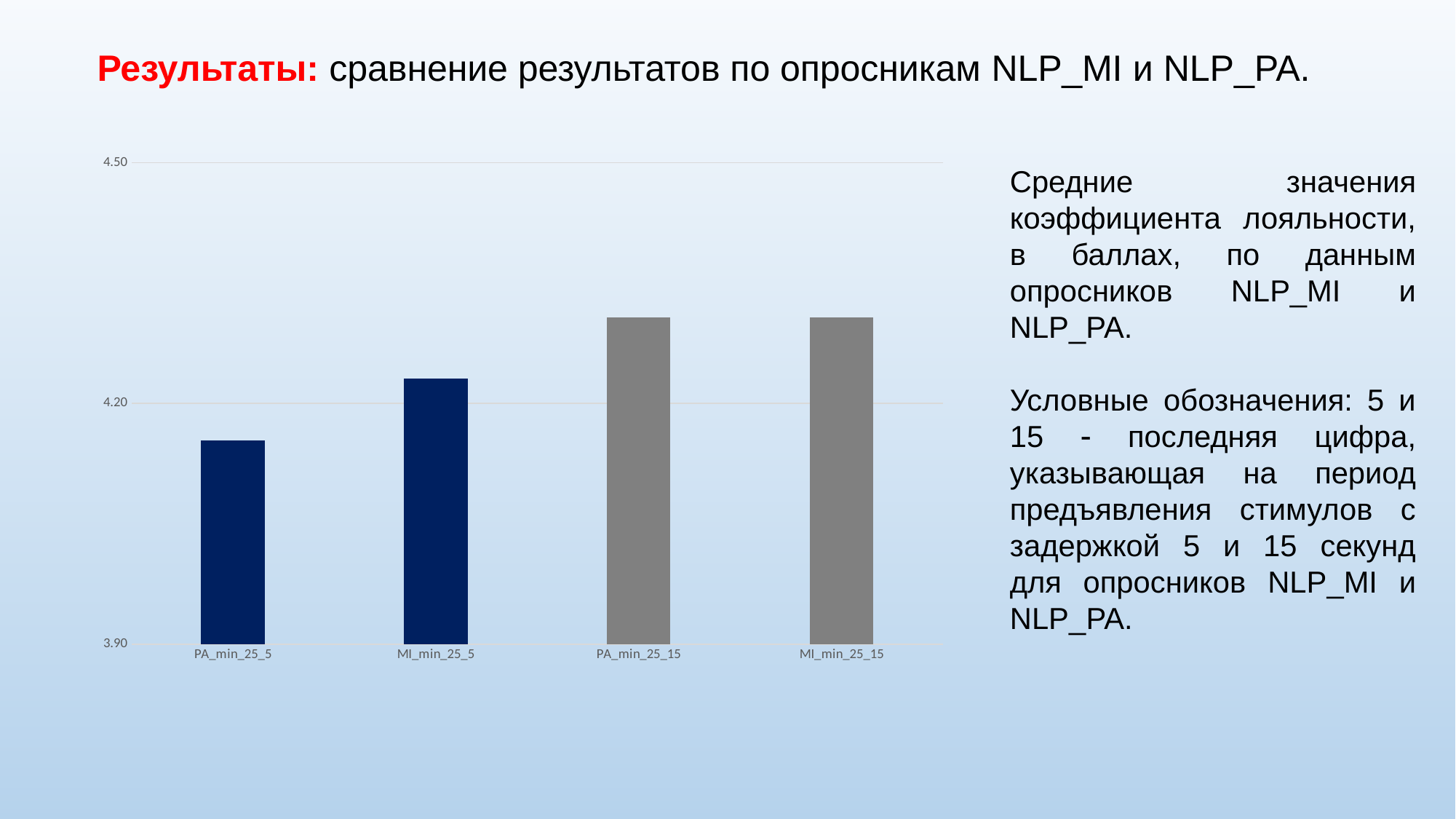
Is the value for PA_min_25_15 greater or less than 4.20? greater What kind of chart is shown on the slide? Bar chart Which is larger, the value for PA_min_25_5 or the value for PA_min_25_15? PA_min_25_15 What is the highest value shown on the vertical axis of the chart? 4.50 Is the value for MI_min_25_15 greater or less than 4.50? less Which category has the lowest value in the chart? PA_min_25_5 What colour are the bars for PA_min_25_15 and MI_min_25_15? Grey Which is larger, the value for PA_min_25_5 or the value for MI_min_25_5? MI_min_25_5 How many bars (categories) are plotted in the chart? 4 Is the value for PA_min_25_5 greater or less than 4.20? less